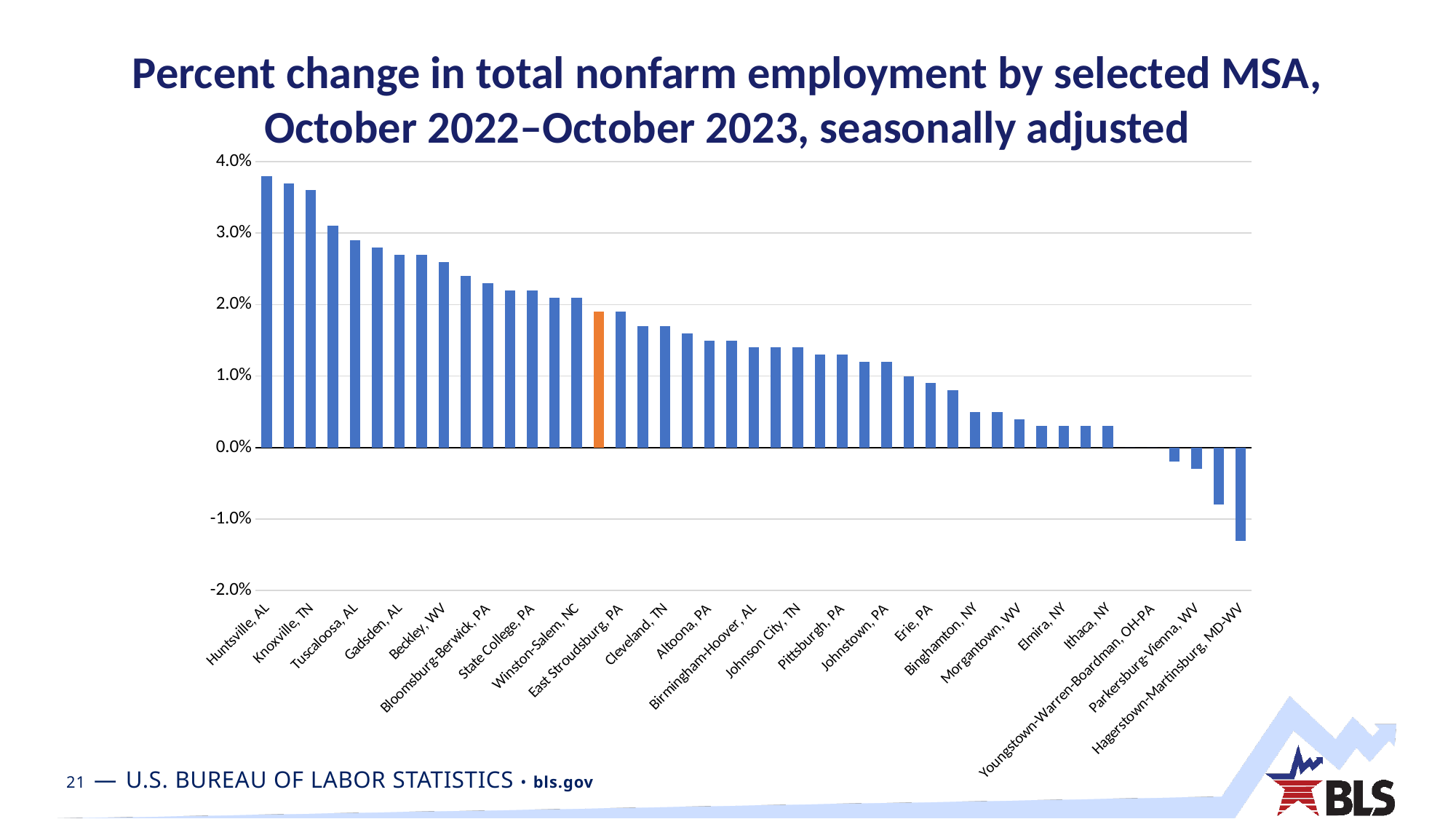
Which MSA has the highest percent change in total nonfarm employment? Huntsville, AL Is the value for Hagerstown-Martinsburg, MD-WV greater or less than -1.0%? less How many bars show a negative percent change? 4 Do the values rise or fall moving from left to right along the x axis? fall What kind of chart is shown on the slide? bar chart Which has the larger percent change, Knoxville, TN or Pittsburgh, PA? Knoxville, TN Is the value for Ithaca, NY greater or less than 1.0%? less Is the value for Huntsville, AL greater or less than 3.0%? greater Which MSA has the lowest percent change in total nonfarm employment? Hagerstown-Martinsburg, MD-WV What colour is the single highlighted bar that differs from the others? orange